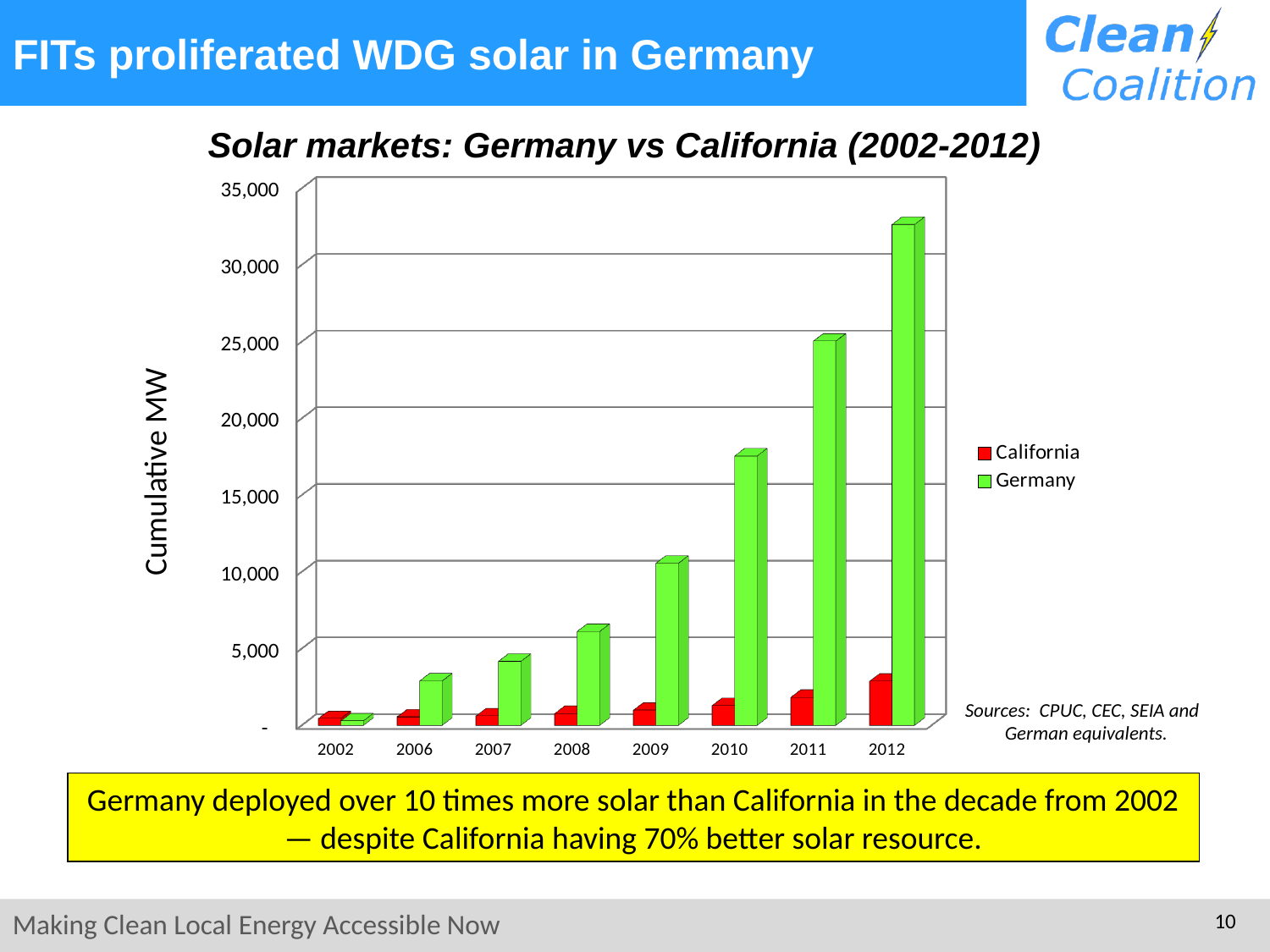
What is the title of the chart? Solar markets: Germany vs California (2002-2012) In 2012, which is larger: the Germany value or the California value? Germany Is the Germany value for 2012 greater or less than 30,000? greater Is the Germany value for 2010 greater or less than 15,000? greater Do the Germany values rise or fall from 2002 to 2012? rise What type of chart is shown on the slide? bar chart How many years are shown on the x axis? 8 Is the California value for 2012 greater or less than 5,000? less In which year is the Germany bar highest? 2012 In which year is the Germany bar lowest? 2002 How many series does the legend list? 2